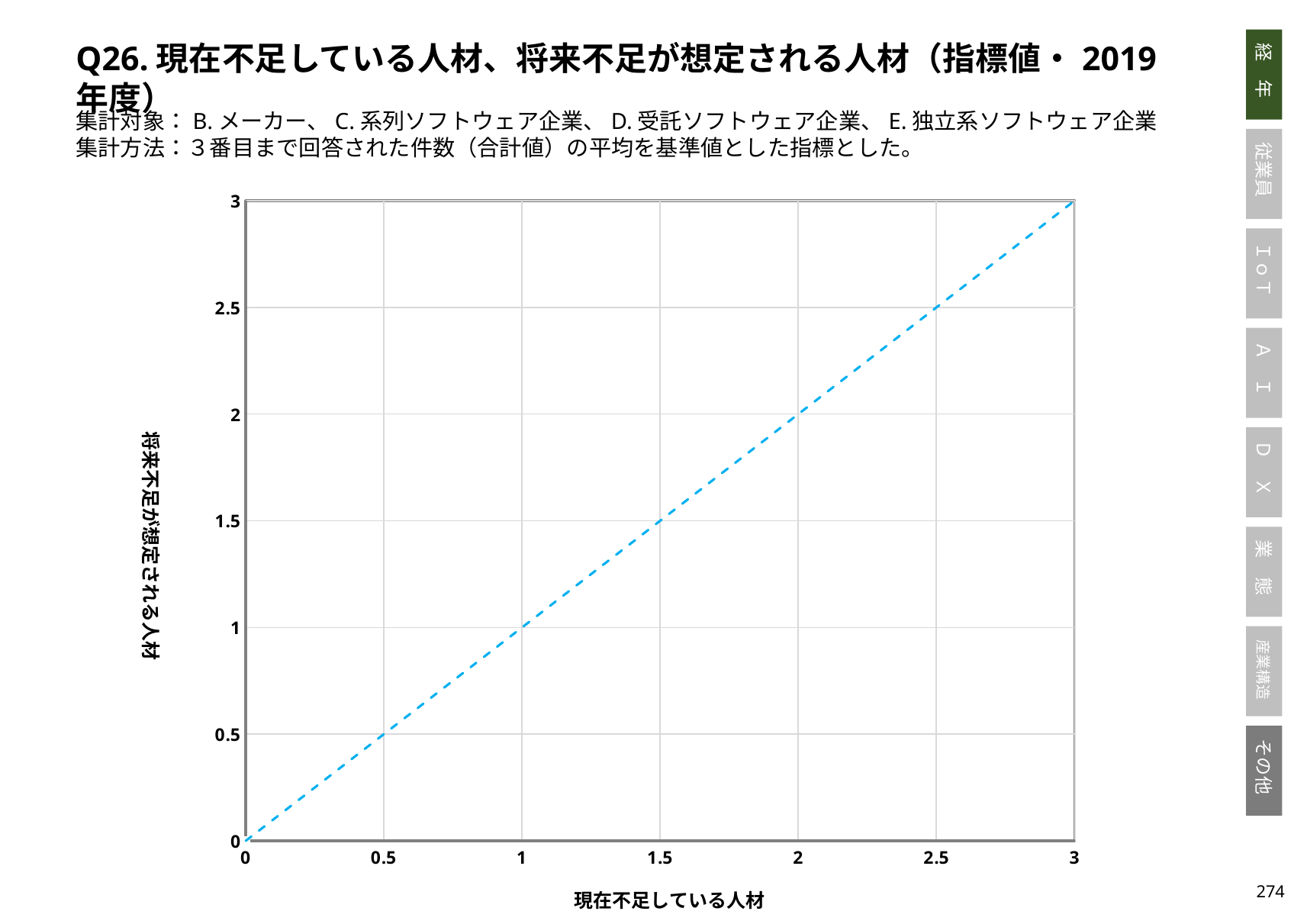
What is the y value of the dashed line where the x value is 1.5? 1.5 What is the label of the y axis? 将来不足が想定される人材 What is the label of the x axis? 現在不足している人材 What is the y value of the dashed line where the x value is 3? 3 Does the dashed line rise or fall as the x-axis value increases? rise How many data points are plotted on the chart apart from the dashed line? 0 What kind of chart is shown on the slide? scatter chart